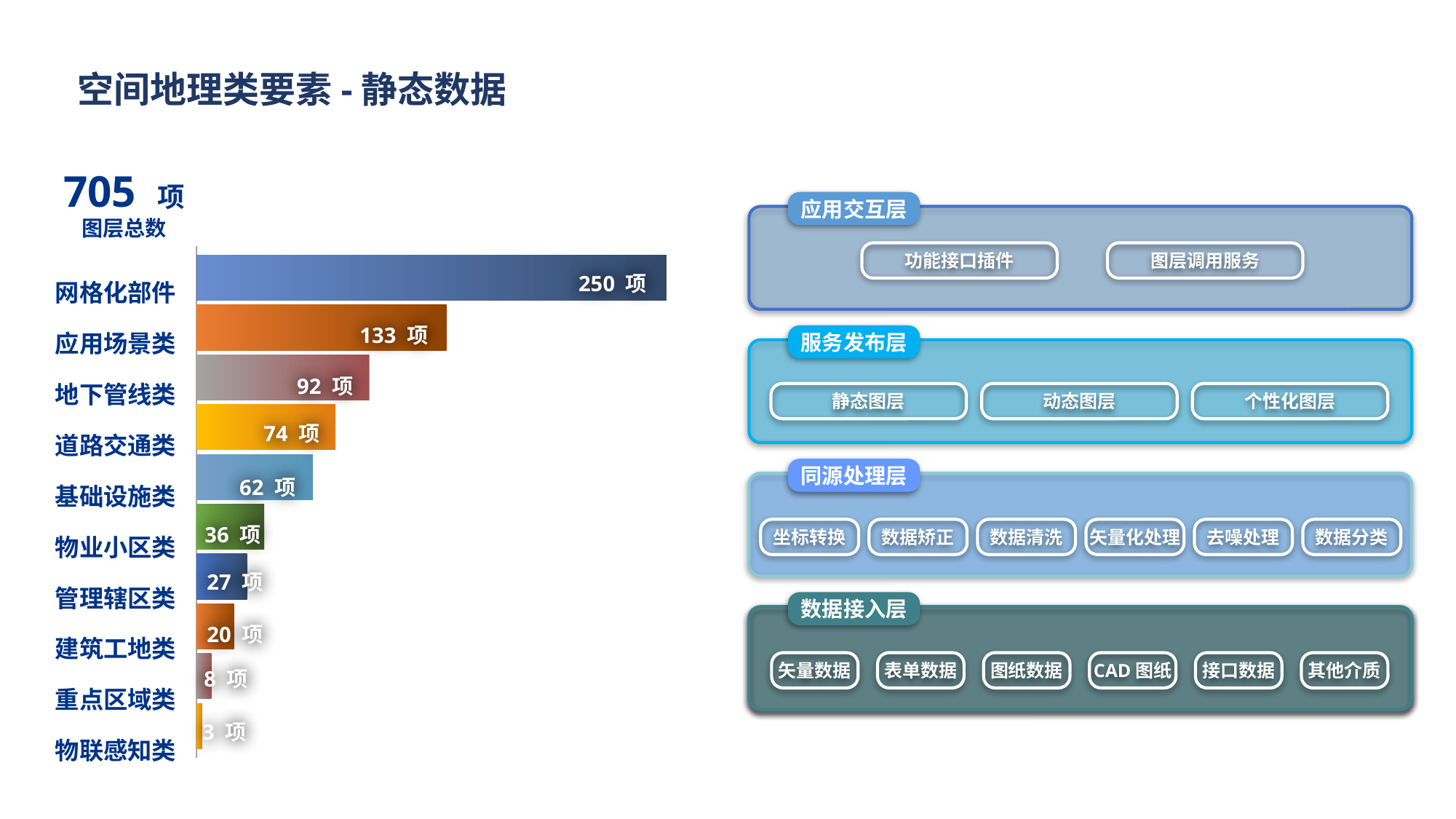
What kind of chart is shown on the slide? bar chart Which category has the lowest value? 物联感知类 What is the value for 地下管线类? 92 项 What is the value for 网格化部件? 250 项 What total number of layers (图层总数) is stated next to the chart? 705 项 What is the value for 物业小区类? 36 项 Which is larger, 管理辖区类 or 建筑工地类? 管理辖区类 How many categories does the bar chart show? 10 What is the difference between 道路交通类 and 基础设施类? 12 项 What is the difference between 网格化部件 and 应用场景类? 117 项 Which category has the highest value? 网格化部件 What is the value for 重点区域类? 8 项